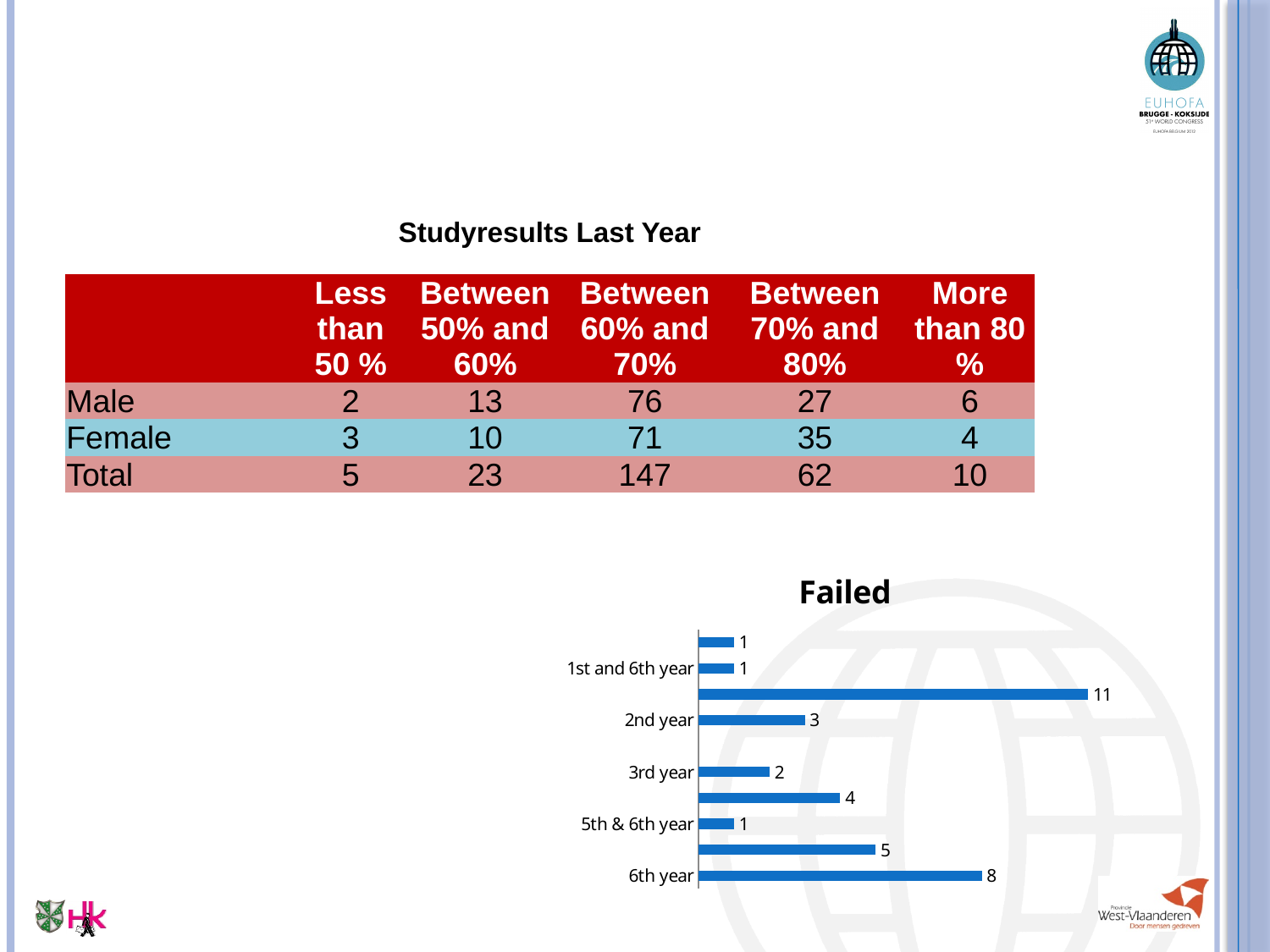
In the "Failed" chart, what is the value for 3rd year? 2 In the "Failed" chart, what is the value for 5th & 6th year? 1 What kind of chart is the "Failed" chart? Bar chart In the "Failed" chart, what is the difference between the values for 6th year and 2nd year? 5 In the "Failed" chart, what is the value for 2nd year? 3 In the "Failed" chart, which of the labelled categories has the highest value? 6th year In the "Failed" chart, what is the largest value shown on any bar? 11 In the "Failed" chart, which is larger, the value for 2nd year or the value for 3rd year? 2nd year In the "Failed" chart, what is the value for 1st and 6th year? 1 What is the title of the chart on the slide? Failed In the "Failed" chart, what is the value for 6th year? 8 How many bars are plotted in the "Failed" chart? 9